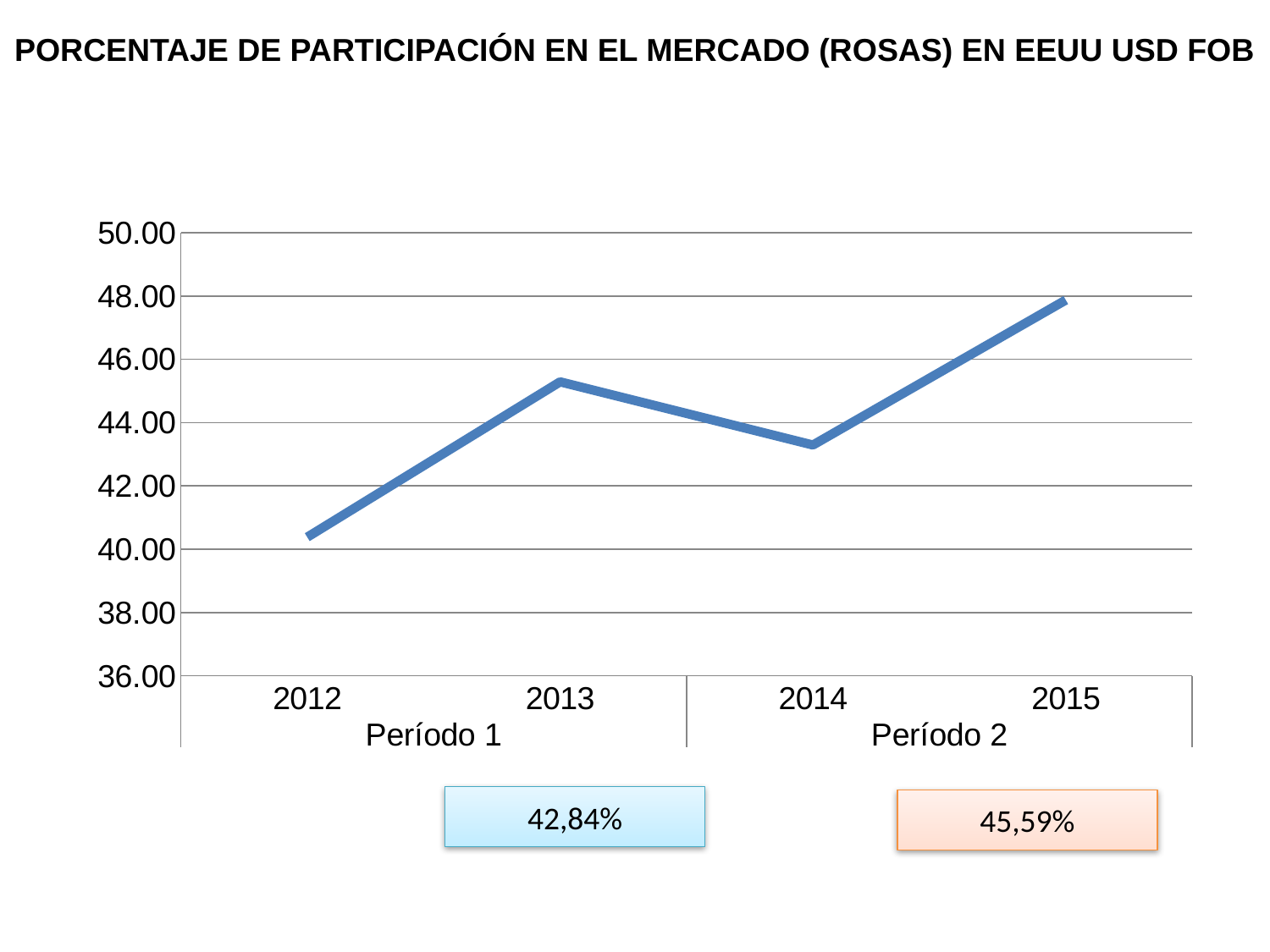
Which year has the lowest value? 2012 Is the value for 2012 greater or less than 42.00? less What kind of chart is shown on the slide? line chart Which year has the highest value? 2015 Is the value for 2014 greater or less than 44.00? less Is the value for 2013 greater or less than 44.00? greater Which two years belong to Período 2 on the x axis? 2014 and 2015 Which is larger, the value for 2013 or the value for 2014? 2013 What percentage is shown in the orange box below Período 2? 45,59% How many years are plotted on the x axis? 4 Does the line rise or fall from 2013 to 2014? fall